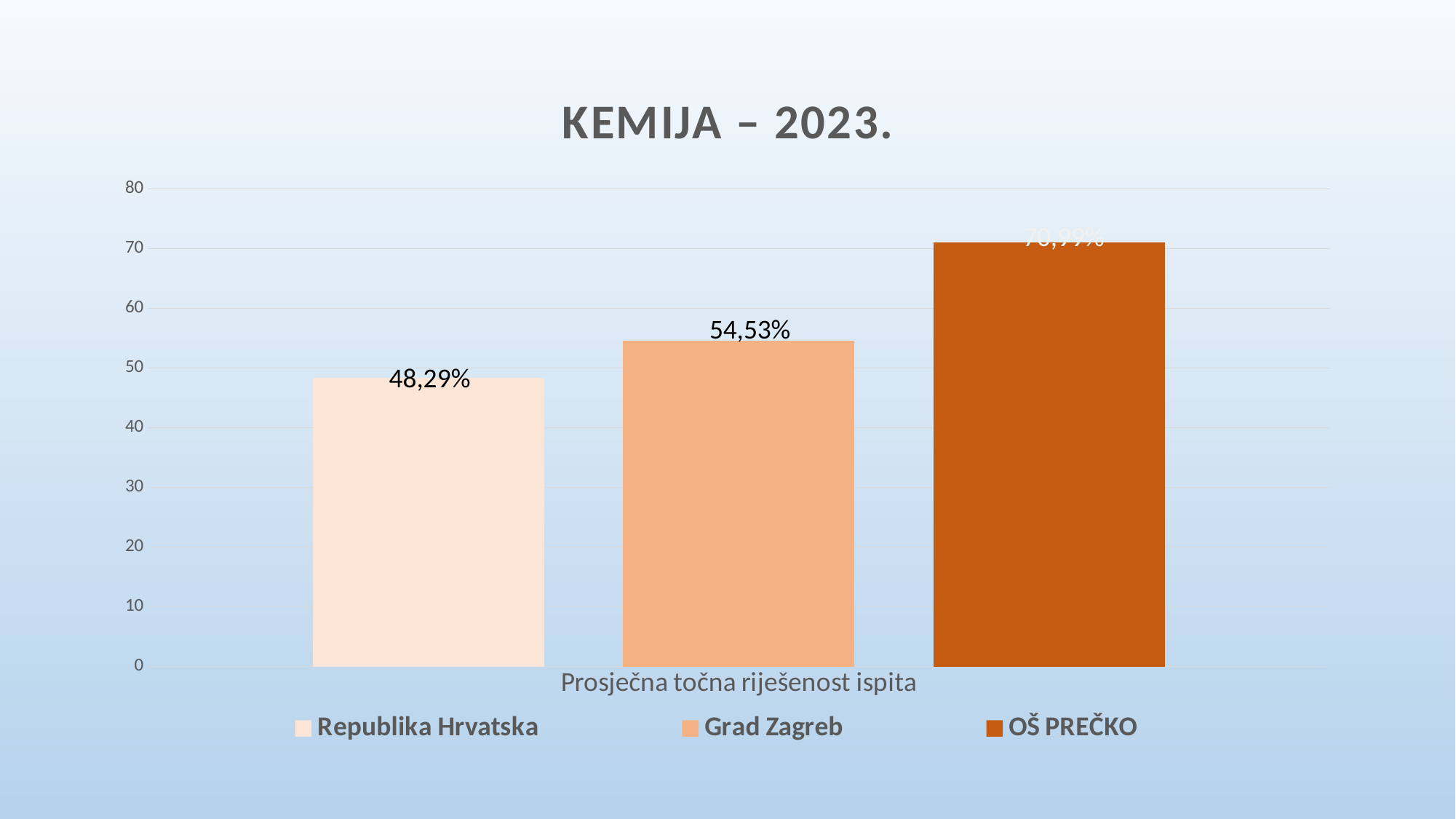
Which is larger, the value for Grad Zagreb or the value for Republika Hrvatska? Grad Zagreb What is the difference between the values for OŠ PREČKO and Grad Zagreb? 16,46% What is the difference between the values for Grad Zagreb and Republika Hrvatska? 6,24% What is the value for OŠ PREČKO? 70,99% Which series has the lowest value? Republika Hrvatska What is the value for Republika Hrvatska? 48,29% What kind of chart is shown on the slide? bar chart How many series does the legend list? 3 What is the value for Grad Zagreb? 54,53% What is the title of the chart? KEMIJA – 2023. Is the value for OŠ PREČKO greater or less than 70? greater Which series has the highest value? OŠ PREČKO